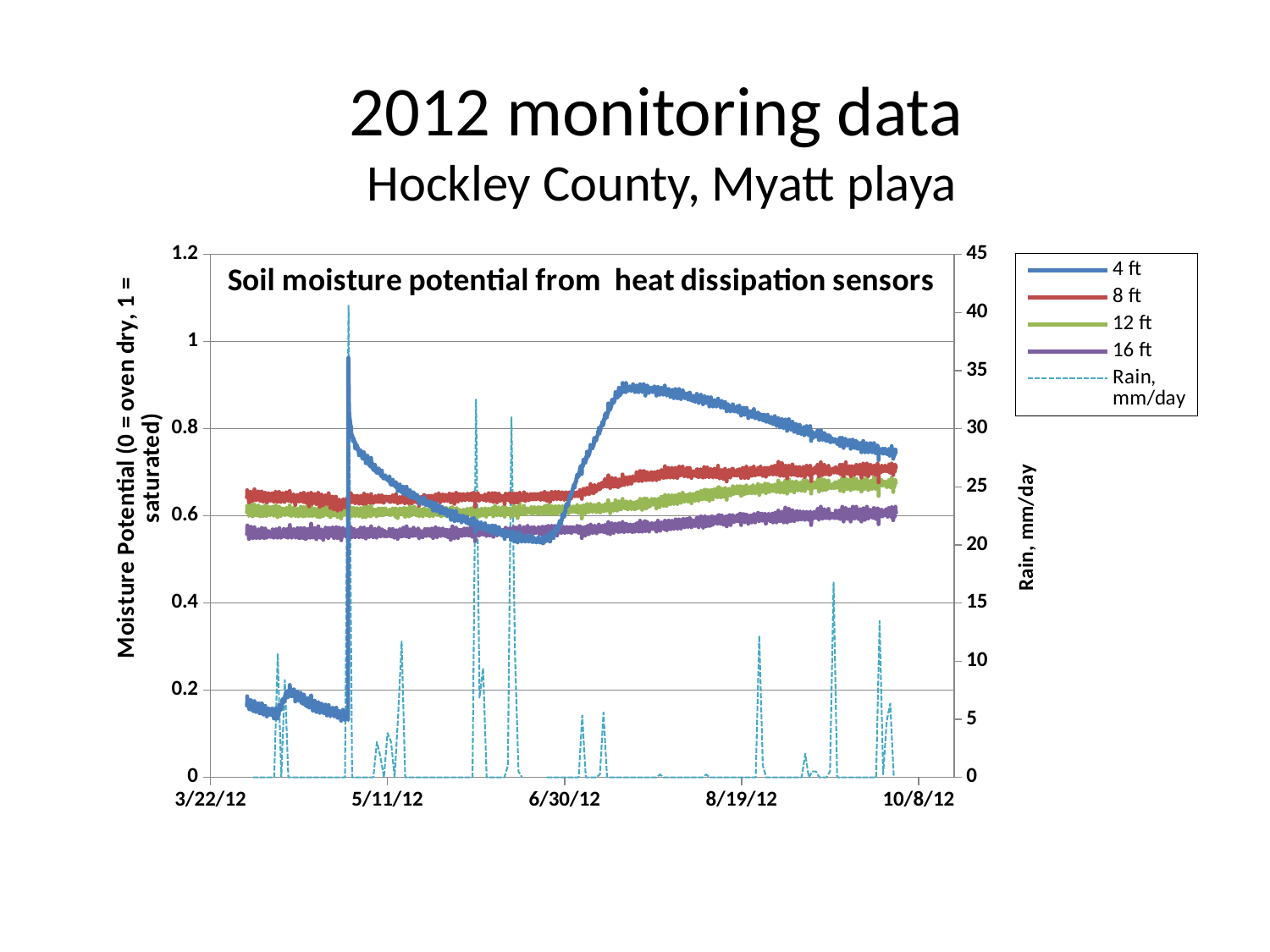
Is the peak of the 4 ft series in mid-July greater or less than 0.8? greater Is the highest rain value on the chart greater or less than 35 mm/day? greater Is the 12 ft moisture potential around 5/11/12 greater or less than 0.8? less What kind of chart is shown on the slide? line chart Around 8/19/12, which series has the higher moisture potential, 4 ft or 16 ft? 4 ft Around 5/11/12, which series has the higher moisture potential, 8 ft or 16 ft? 8 ft Does the 8 ft series rise or fall between 6/30/12 and 10/8/12? rise How many series does the legend list? 5 What is the label of the right-hand vertical axis? Rain, mm/day Does the 4 ft series rise or fall from its mid-July peak to 10/8/12? fall What is the title printed inside the chart? Soil moisture potential from heat dissipation sensors